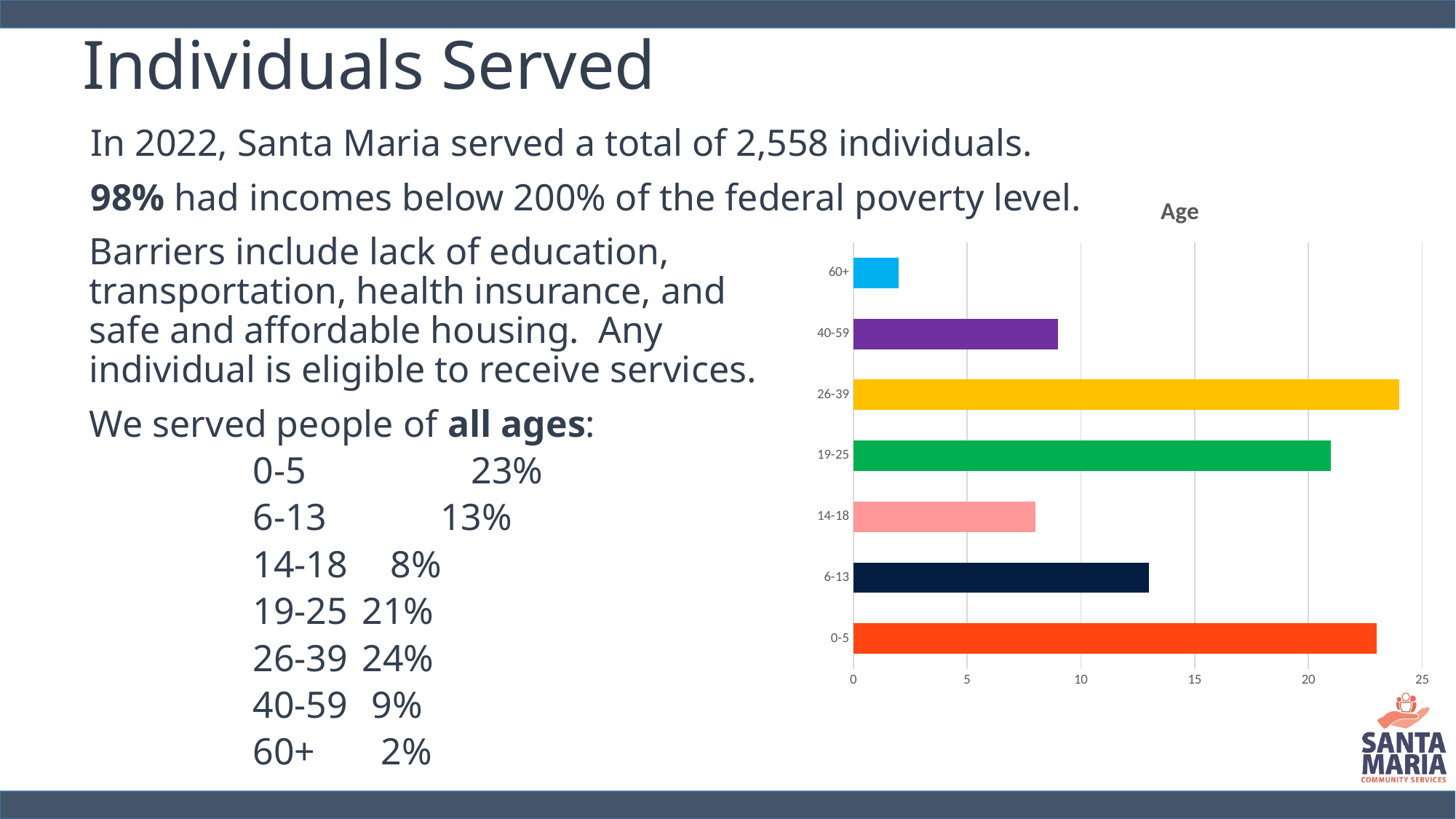
Is the value for the 14-18 age group greater or less than 10? less What is the difference between the shares for the 19-25 and 14-18 age groups? 13% What type of chart is shown on the slide? bar chart According to the slide, what share of people served were aged 40-59? 9% Which age group has the lowest value in the chart? 60+ According to the slide, what share of people served were aged 0-5? 23% How many age categories does the chart show? 7 What is the title of the chart? Age According to the slide, what share of people served were aged 19-25? 21% Which age group has a larger value, 19-25 or 6-13? 19-25 Is the value for the 6-13 age group greater or less than 10? greater Which age group has the highest value in the chart? 26-39